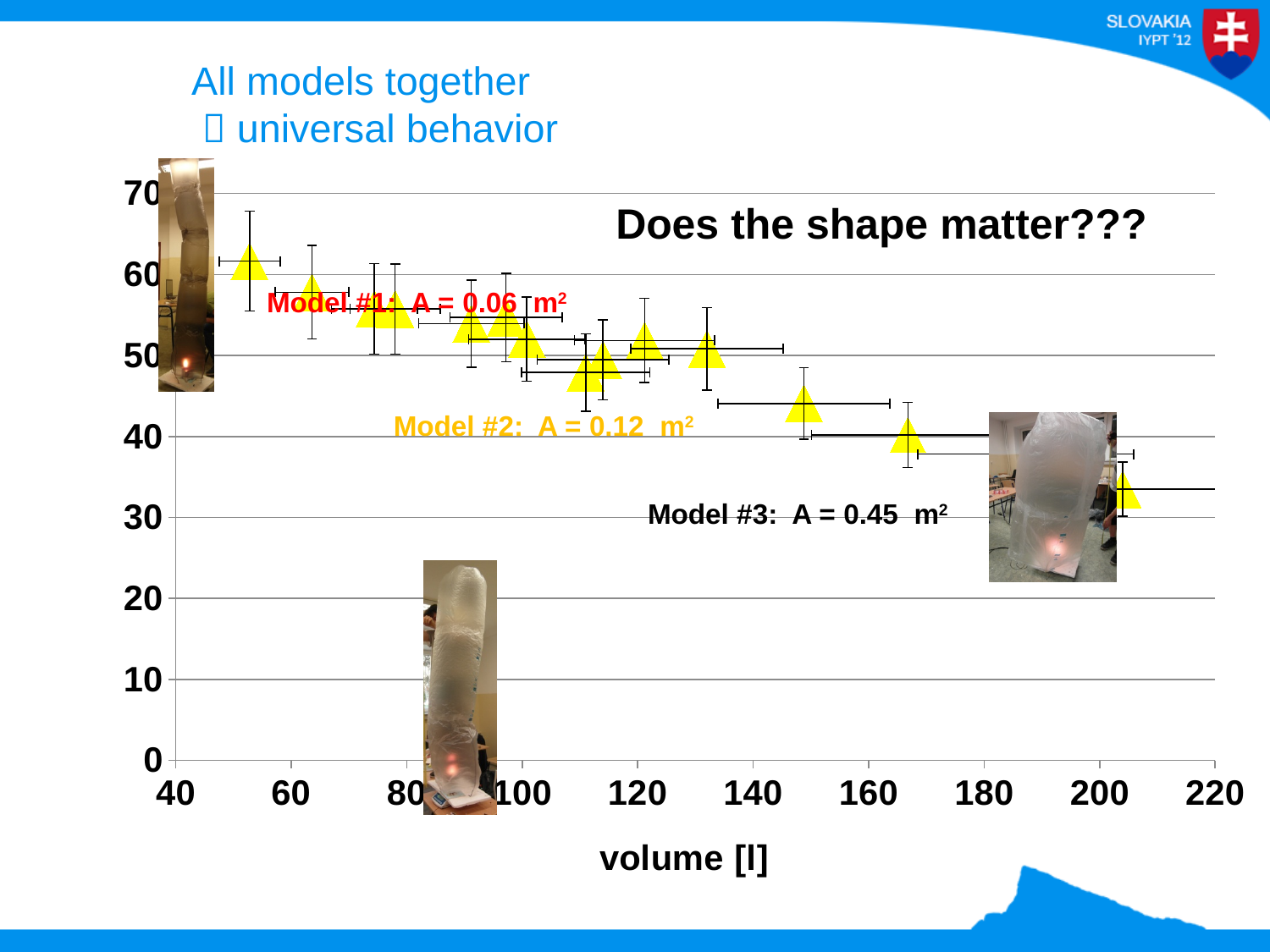
Is the value of the data point near 150 l greater or less than 50? less Is the value of the data point near 63 l greater or less than 40? greater What is the highest value shown on the x axis of the chart? 220 What is the label of the x axis of the chart? volume [l] According to the annotation on the chart, what is the area A of Model #1? 0.06 m² Which data point has the higher value: the one near 53 l or the one near 205 l? the one near 53 l What kind of chart is shown on the slide? scatter chart Is the value of the rightmost data point (near 205 l) greater or less than 40? less As volume increases along the x axis, do the plotted values generally rise or fall? fall According to the annotation on the chart, what is the area A of Model #3? 0.45 m²